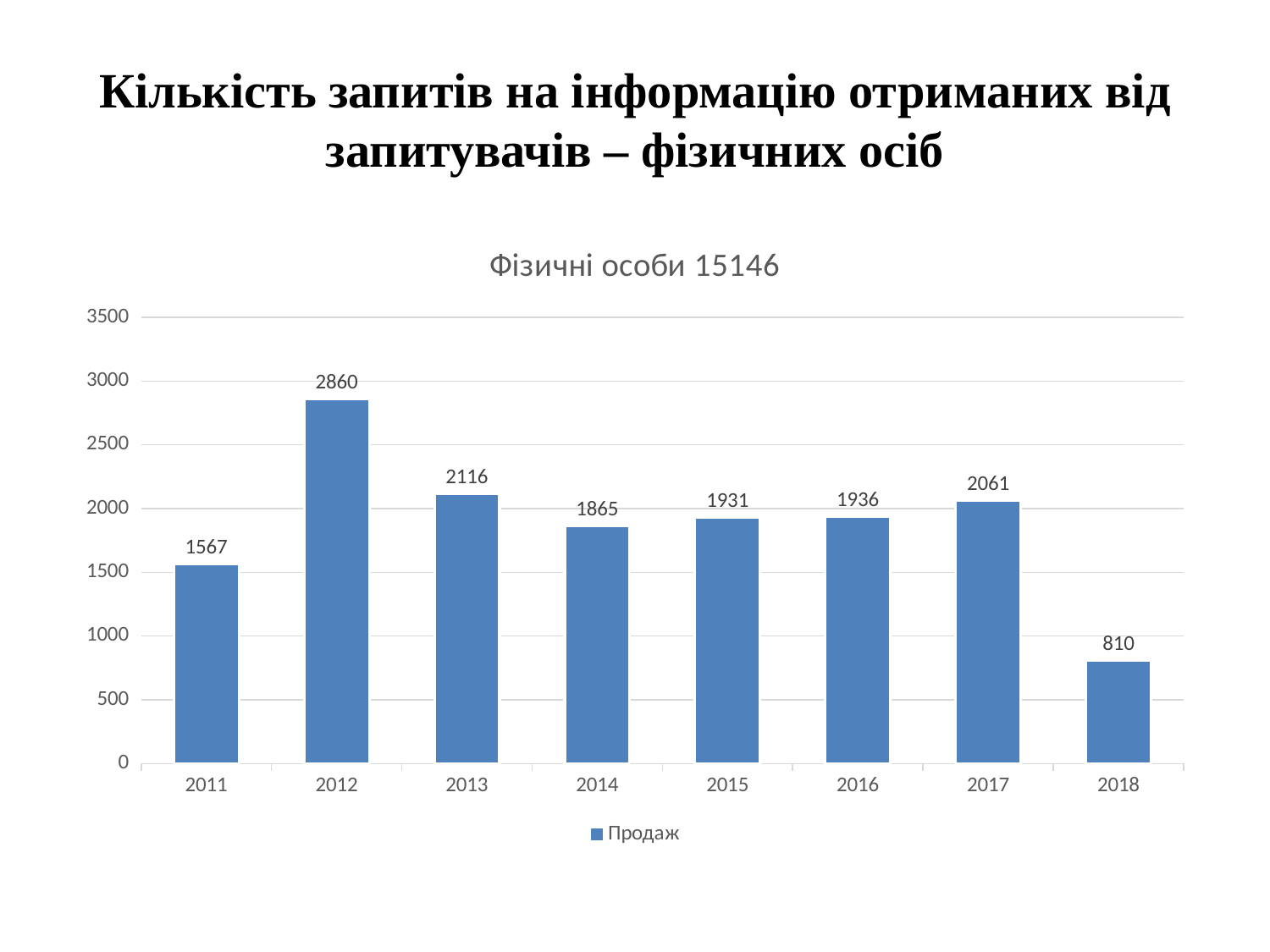
Which is larger, the value for 2013 or the value for 2017? 2013 How many series does the legend list? 1 Which year has the lowest value? 2018 What kind of chart is shown? bar chart What is the value for 2018? 810 What is the value for 2012? 2860 How many years are shown on the x axis? 8 What is the difference between the values for 2012 and 2011? 1293 Is the value for 2014 greater or less than 2000? less What is the value for 2015? 1931 Which year has the highest value? 2012 What is the chart's title? Фізичні особи 15146